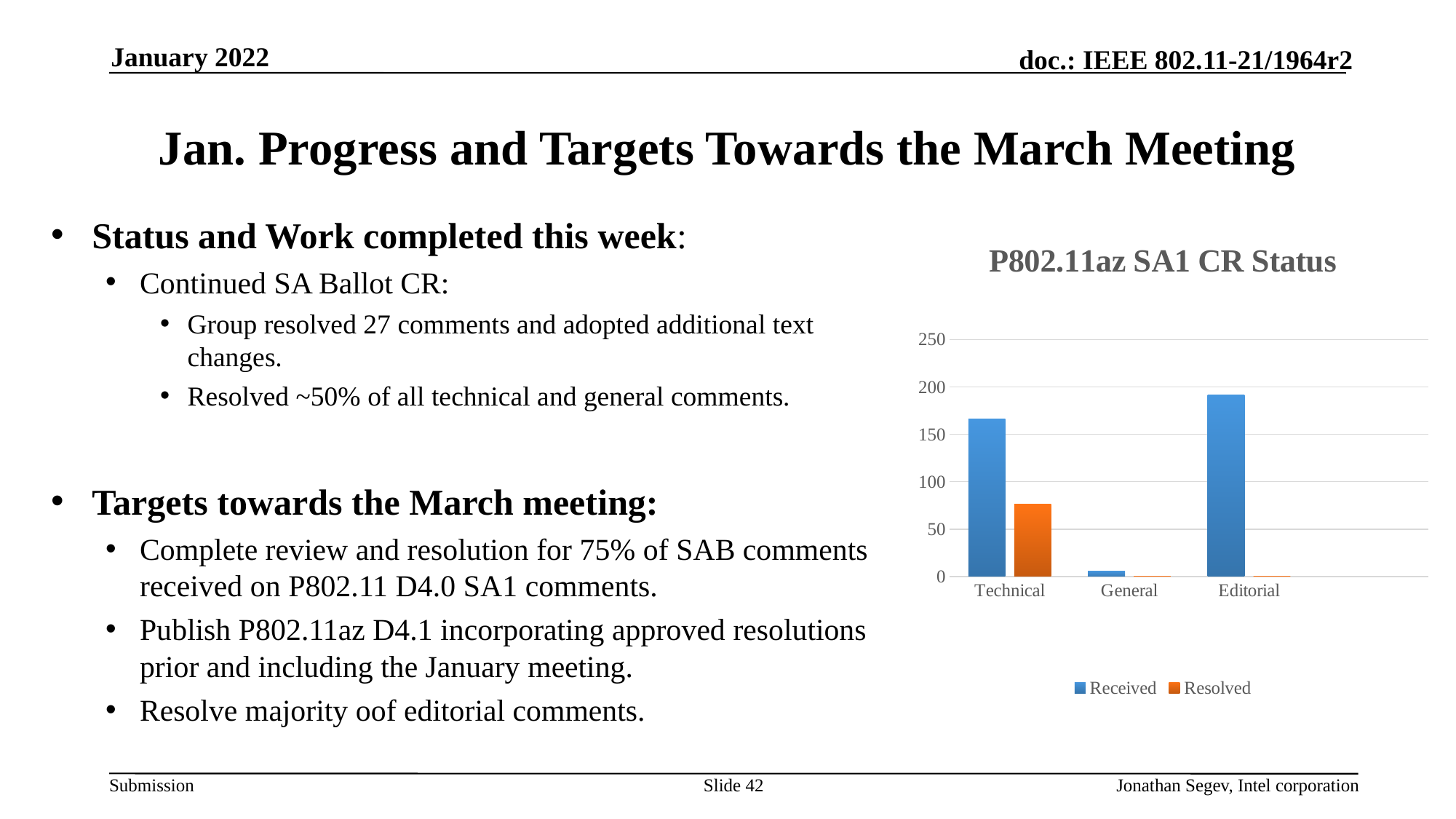
How many series does the chart legend list? 2 What is the title of the chart on the slide? P802.11az SA1 CR Status Which is larger, the Received value for Editorial or the Received value for Technical? Editorial Which category has the highest Received value? Editorial Which category has the lowest Received value? General Is the Received value for General greater or less than 50? less What kind of chart is shown on the slide? bar chart Is the Received value for Editorial greater or less than 200? less Is the Received value for Technical greater or less than 150? greater How many categories are shown on the x axis of the chart? 3 Which series is shown in orange in the chart? Resolved